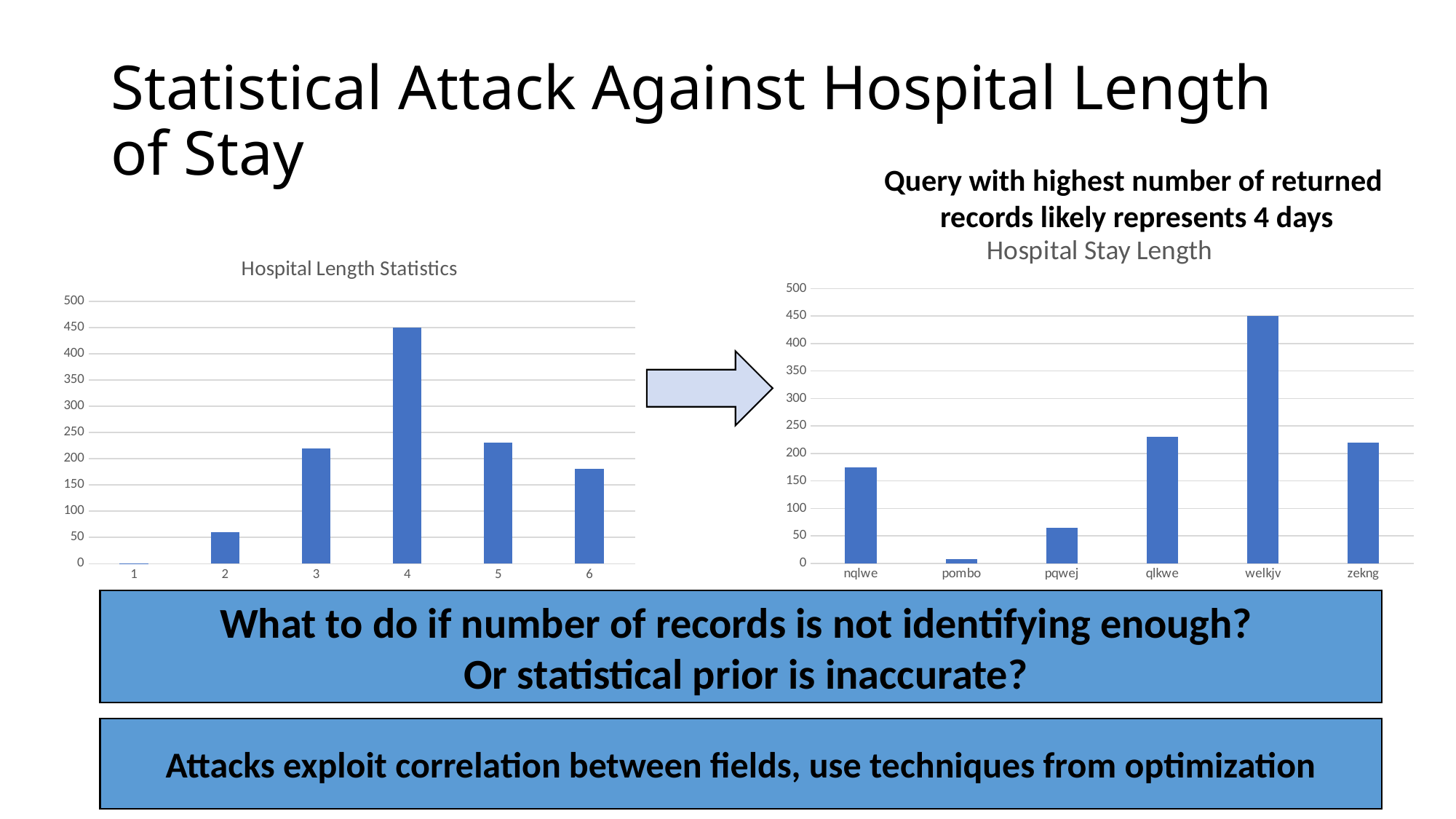
In the Hospital Stay Length chart, is the value for pqwej greater or less than 100? less In the Hospital Length Statistics chart, which is larger, the value for category 3 or category 6? 3 In the Hospital Stay Length chart, which category has the highest value? welkjv In the Hospital Stay Length chart, which category has the lowest value? pombo In the Hospital Length Statistics chart, which category has the lowest value? 1 In the Hospital Length Statistics chart, is the value for category 2 greater or less than 100? less In the Hospital Length Statistics chart, is the value for category 3 greater or less than 200? greater In the Hospital Length Statistics chart, which category has the highest value? 4 In the Hospital Stay Length chart, which is larger, the value for nqlwe or pqwej? nqlwe How many categories are shown in the Hospital Length Statistics chart? 6 What kind of chart is the Hospital Stay Length chart? bar chart In the Hospital Length Statistics chart, what is the value for category 4? 450